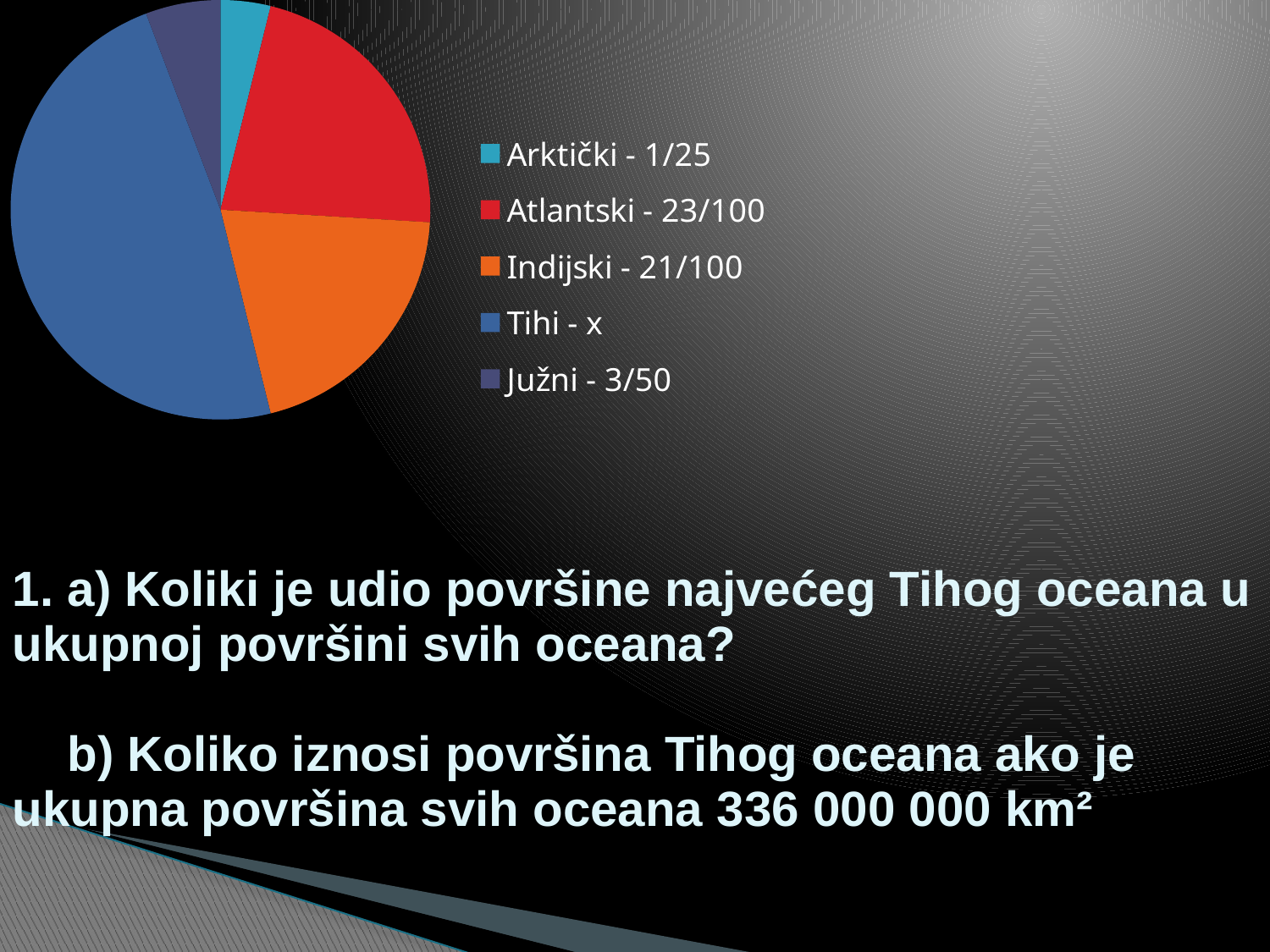
Which category has the smallest slice in the pie chart? Arktički What fraction is given for Indijski in the legend? 21/100 How many categories (slices) does the pie chart have? 5 What fraction is given for Atlantski in the legend? 23/100 What colour is the Atlantski slice in the pie chart? red What fraction is given for Arktički in the legend? 1/25 What kind of chart is shown on the slide? pie chart What fraction is given for Južni in the legend? 3/50 Which category has the largest slice in the pie chart? Tihi What colour is the Tihi slice in the pie chart? blue What value is given for Tihi in the legend? x Which is larger according to the legend, Atlantski or Indijski? Atlantski